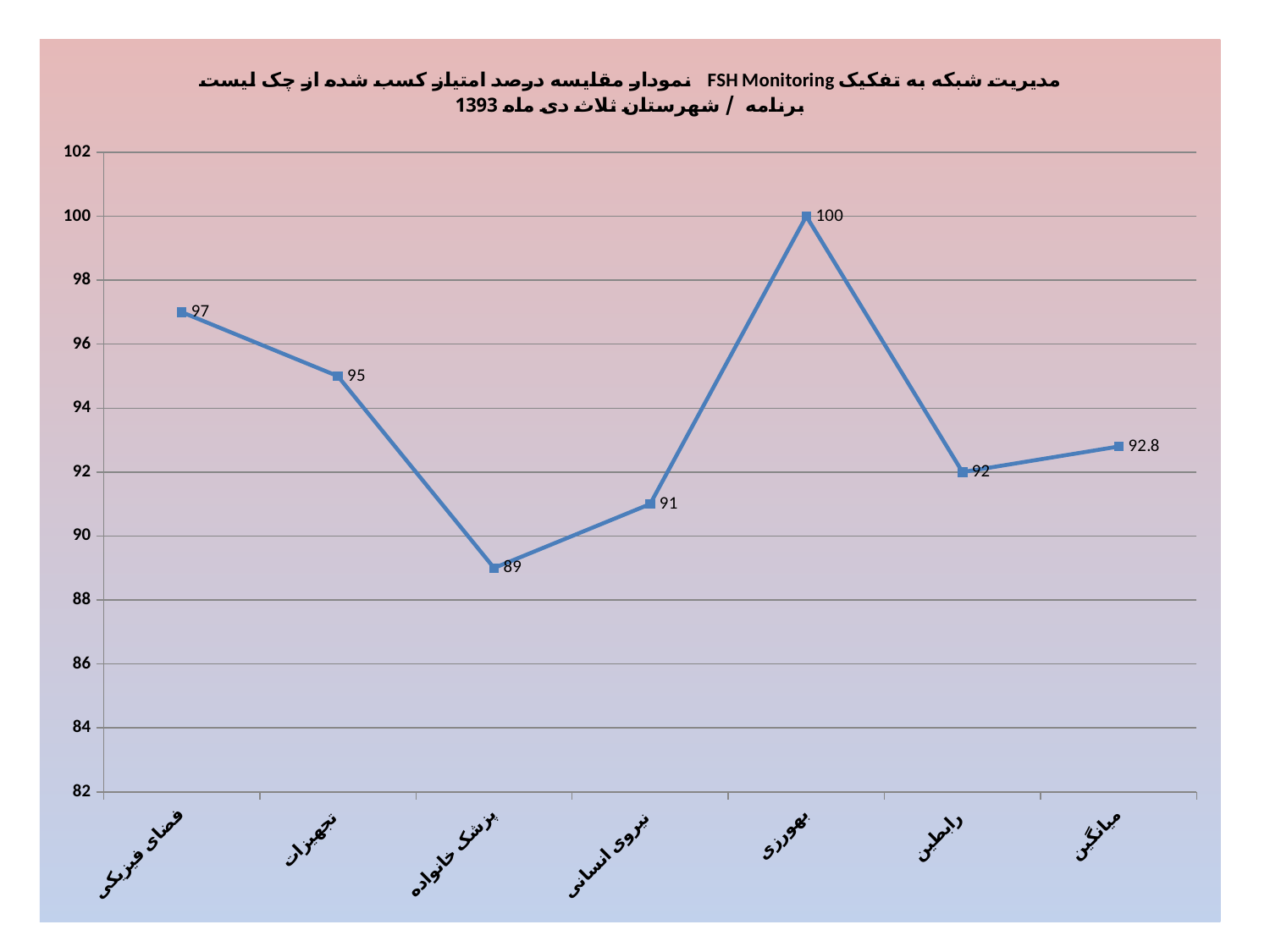
Which is larger, the value for تجهیزات or the value for رابطین? تجهیزات What is the value for میانگین? 92.8 Is the value for نیروی انسانی greater or less than 92? less What type of chart is shown on the slide? line chart Which category has the lowest value? پزشک خانواده What is the value for پزشک خانواده? 89 Do the values rise or fall from فضای فیزیکی to پزشک خانواده? fall What is the value for فضای فیزیکی? 97 Which category has the highest value? بهورزی How many categories are plotted on the x axis? 7 What is the value for بهورزی? 100 What is the difference between the values for بهورزی and پزشک خانواده? 11